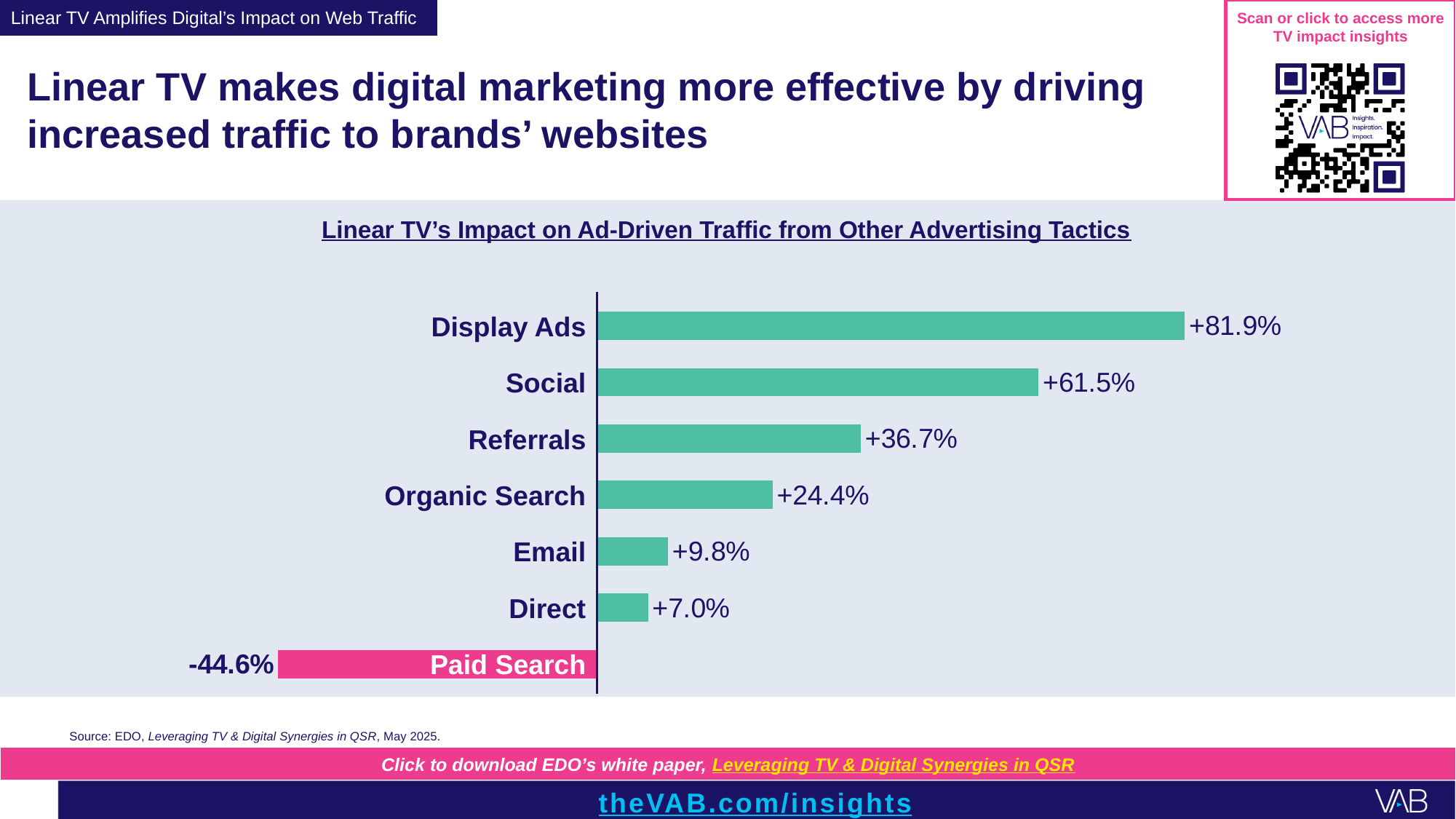
What is the title of the chart? Linear TV's Impact on Ad-Driven Traffic from Other Advertising Tactics How many categories are shown in the chart? 7 What kind of chart is shown on the slide? Bar chart Which has a larger value, Referrals or Organic Search? Referrals Which category has the highest value? Display Ads What is the value shown for Paid Search? -44.6% Which category has the lowest value? Paid Search Which category's bar is coloured pink rather than green? Paid Search What is the difference between the values for Email and Direct? 2.8 percentage points What is the value shown for Display Ads? +81.9% What is the difference between the values for Display Ads and Social? 20.4 percentage points What is the value shown for Organic Search? +24.4%